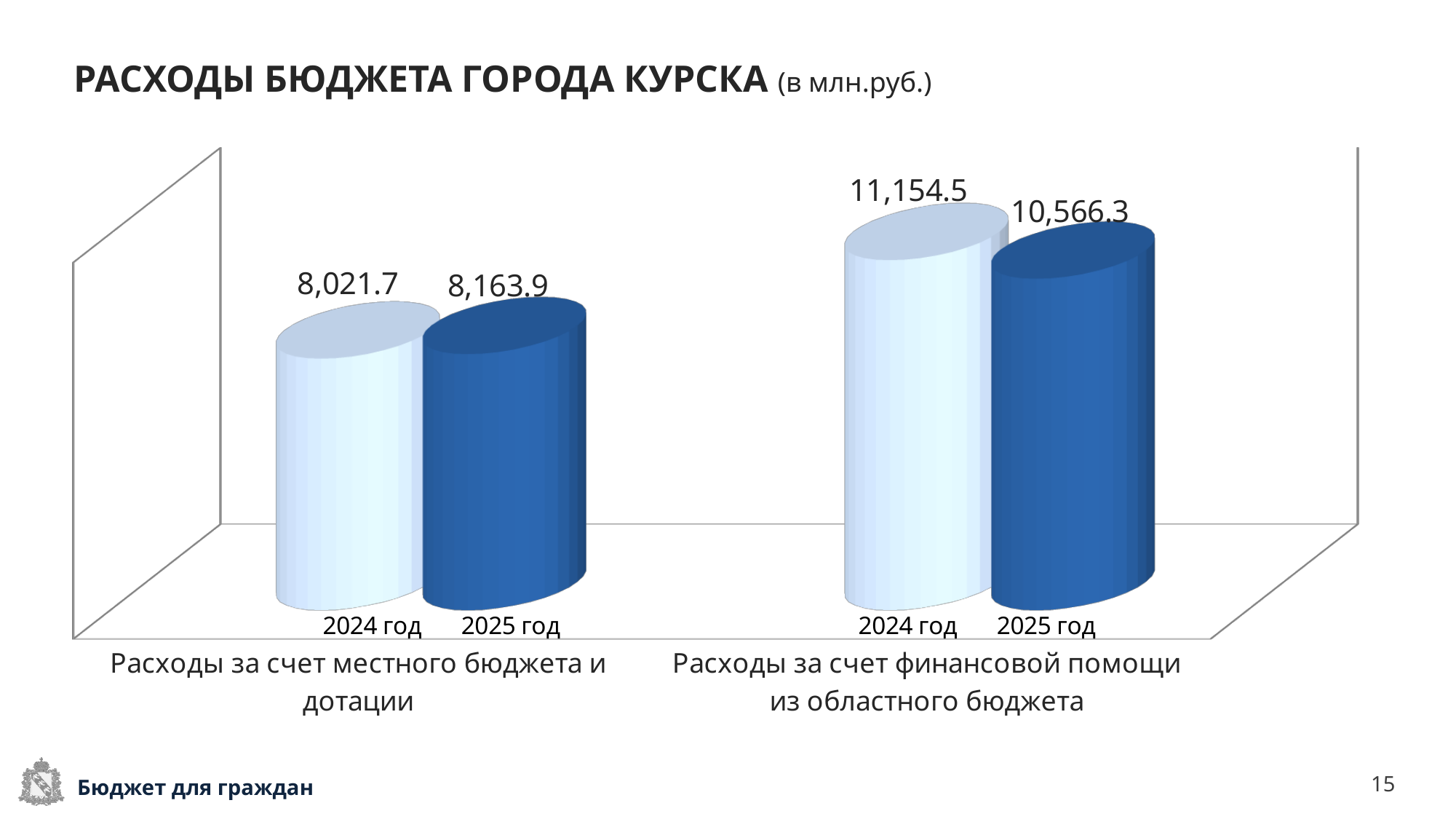
For «Расходы за счет финансовой помощи из областного бюджета», which year has the larger value, 2024 год or 2025 год? 2024 год What kind of chart is shown on the slide? Bar chart How many categories are shown on the x axis of the chart? 2 What is the value for 2025 год under «Расходы за счет местного бюджета и дотации»? 8,163.9 What is the value for 2025 год under «Расходы за счет финансовой помощи из областного бюджета»? 10,566.3 What is the difference between the 2025 год and 2024 год values for «Расходы за счет местного бюджета и дотации»? 142.2 Which bar has the lowest value on the chart? 2024 год, Расходы за счет местного бюджета и дотации What is the value for 2024 год under «Расходы за счет финансовой помощи из областного бюджета»? 11,154.5 What is the title of the chart? РАСХОДЫ БЮДЖЕТА ГОРОДА КУРСКА (в млн.руб.) Which bar has the highest value on the chart? 2024 год, Расходы за счет финансовой помощи из областного бюджета What is the value for 2024 год under «Расходы за счет местного бюджета и дотации»? 8,021.7 What is the difference between the 2024 год and 2025 год values for «Расходы за счет финансовой помощи из областного бюджета»? 588.2